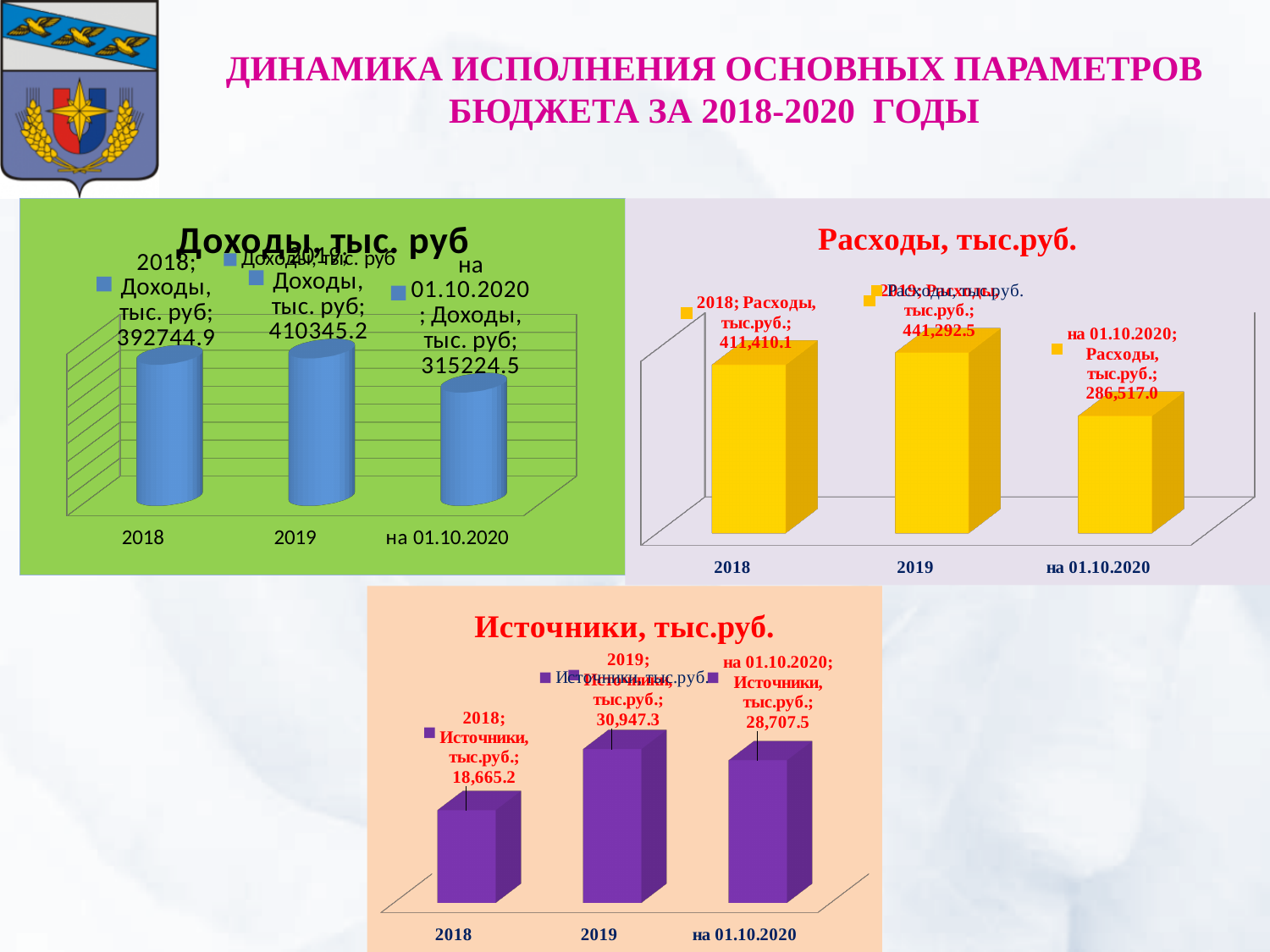
In the chart titled "Источники, тыс.руб.", which is larger, the value for 2019 or the value for на 01.10.2020? 2019 In the chart titled "Источники, тыс.руб.", what is the difference between the 2019 and на 01.10.2020 values? 2,239.8 In the chart titled "Доходы, тыс. руб", which category has the lowest value? на 01.10.2020 What colour are the bars in the chart titled "Источники, тыс.руб."? purple How many categories are shown in the chart titled "Источники, тыс.руб."? 3 In the chart titled "Расходы, тыс.руб.", what is the value for 2018? 411,410.1 In the chart titled "Расходы, тыс.руб.", what is the difference between the 2019 and 2018 values? 29,882.4 In the chart titled "Расходы, тыс.руб.", which category has the highest value? 2019 In the chart titled "Доходы, тыс. руб", what is the difference between the 2019 and 2018 values? 17600.3 What kind of chart is the chart titled "Расходы, тыс.руб."? bar chart In the chart titled "Источники, тыс.руб.", what is the value for на 01.10.2020? 28,707.5 In the chart titled "Доходы, тыс. руб", what is the value for 2019? 410345.2